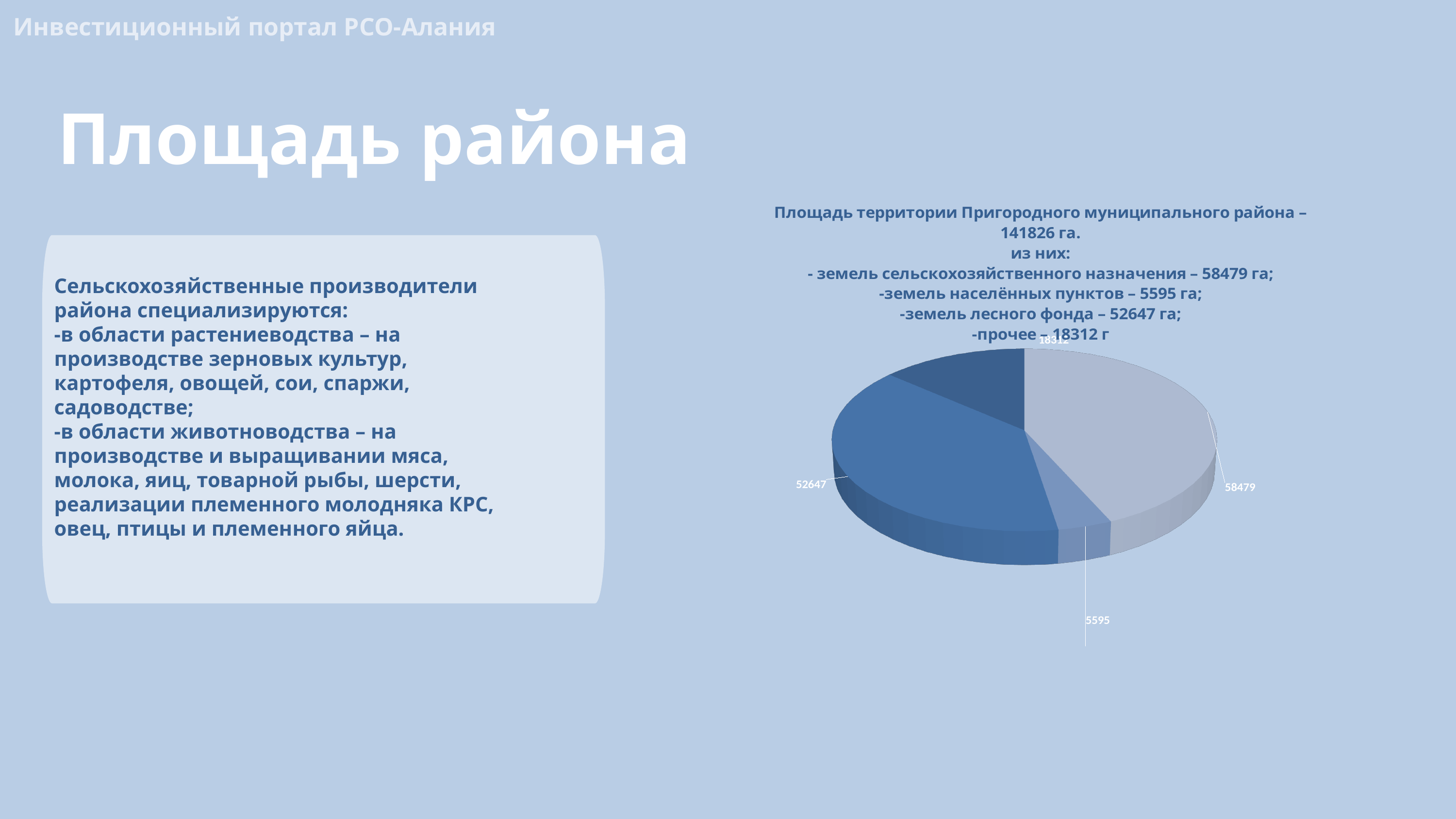
What value is shown for прочее in the pie chart? 18312 What value is shown for земель сельскохозяйственного назначения in the pie chart? 58479 What value is shown for земель населённых пунктов in the pie chart? 5595 What is the difference between the values for земель сельскохозяйственного назначения and земель лесного фонда? 5832 Which category has the smallest slice in the pie chart? земель населённых пунктов According to the chart title, what is the total area of the Пригородный municipal district? 141826 га What is the difference between the values for прочее and земель населённых пунктов? 12717 What kind of chart is shown on the slide? pie chart Which category has the largest slice in the pie chart? земель сельскохозяйственного назначения What value is shown for земель лесного фонда in the pie chart? 52647 How many slices does the pie chart have? 4 Which is larger in the pie chart: земель лесного фонда or прочее? земель лесного фонда